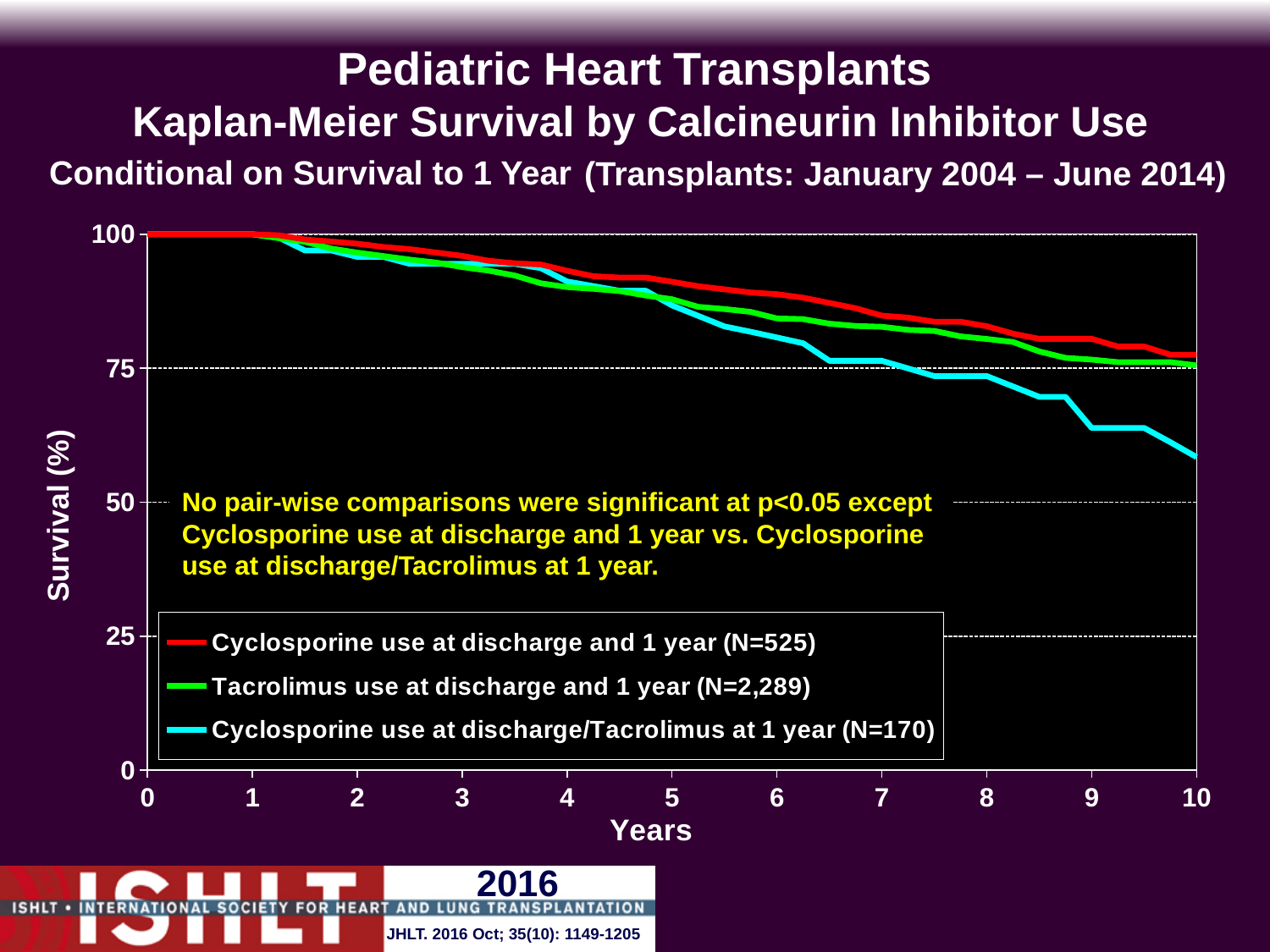
Which series has the highest survival at 10 years? Cyclosporine use at discharge and 1 year Is the survival for Cyclosporine use at discharge/Tacrolimus at 1 year at 9 years greater or less than 75? less Do the survival curves rise or fall as years increase? Fall Is the survival for Tacrolimus use at discharge and 1 year at 5 years greater or less than 75? greater Is the survival for Cyclosporine use at discharge/Tacrolimus at 1 year at 10 years greater or less than 75? less At 9 years, which series has higher survival: Tacrolimus use at discharge and 1 year or Cyclosporine use at discharge/Tacrolimus at 1 year? Tacrolimus use at discharge and 1 year How many series does the legend list? 3 Which series has the lowest survival at 10 years? Cyclosporine use at discharge/Tacrolimus at 1 year What colour is the line for Cyclosporine use at discharge/Tacrolimus at 1 year? Cyan What is the N for the Tacrolimus use at discharge and 1 year series? N=2,289 What kind of chart is shown on the slide? Line chart